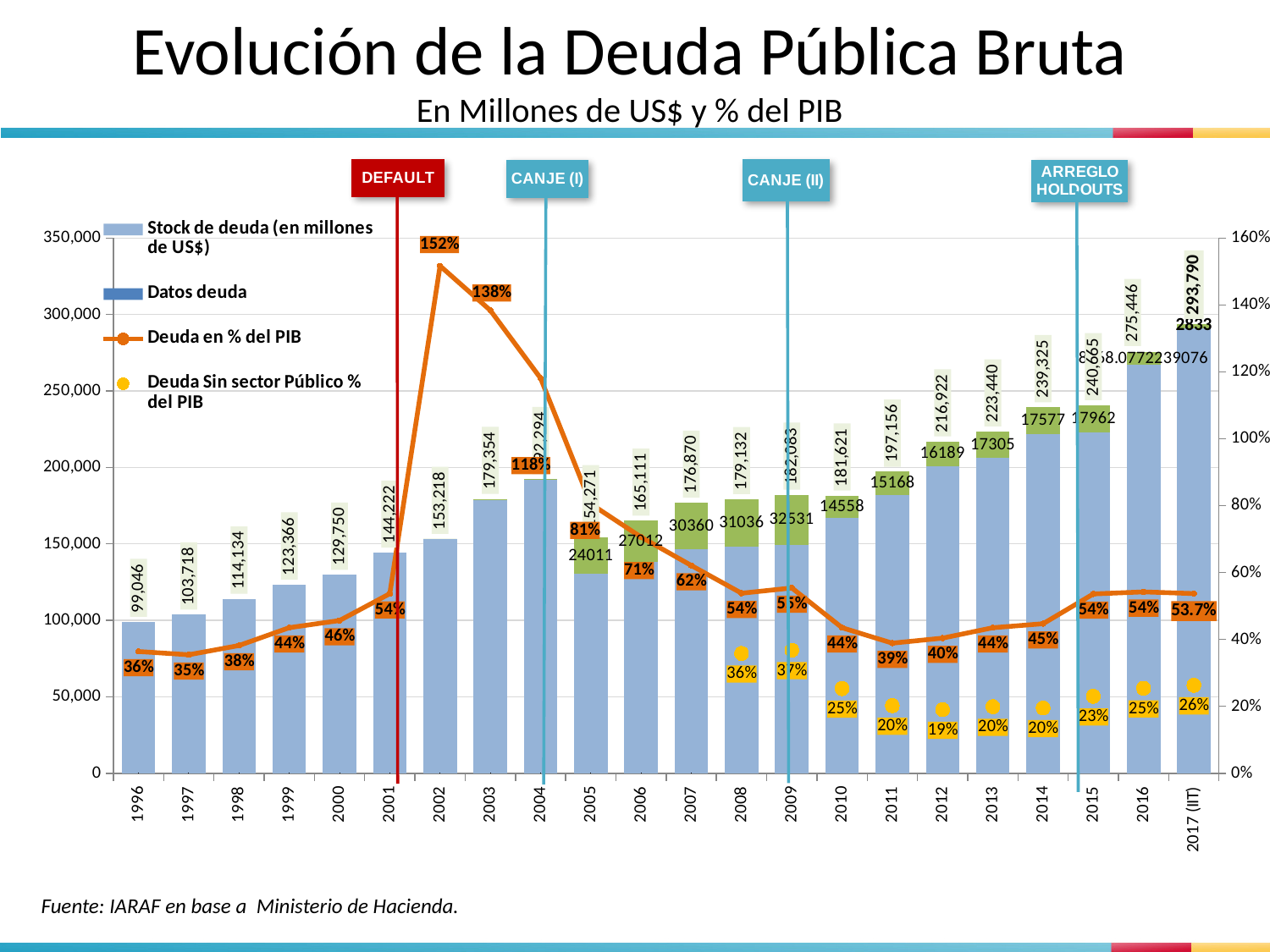
How many years are shown on the x axis? 22 How many series does the legend list? 4 What is the stock of debt (Stock de deuda) for 1996? 99,046 What is the value of Deuda en % del PIB for 2002? 152% Which year has a larger stock of debt, 2012 or 2013? 2013 What is the difference between the stock of debt in 2017 (IIT) and in 2016? 18,344 What is the value of Deuda Sin sector Público % del PIB for 2012? 19% Which year has the highest stock of debt? 2017 (IIT) Does the stock of debt rise or fall from 1996 to 2001? Rises In which year does Deuda en % del PIB reach its highest value? 2002 In which year is Deuda en % del PIB at its lowest? 1997 What kind of chart is this? Combined bar and line chart